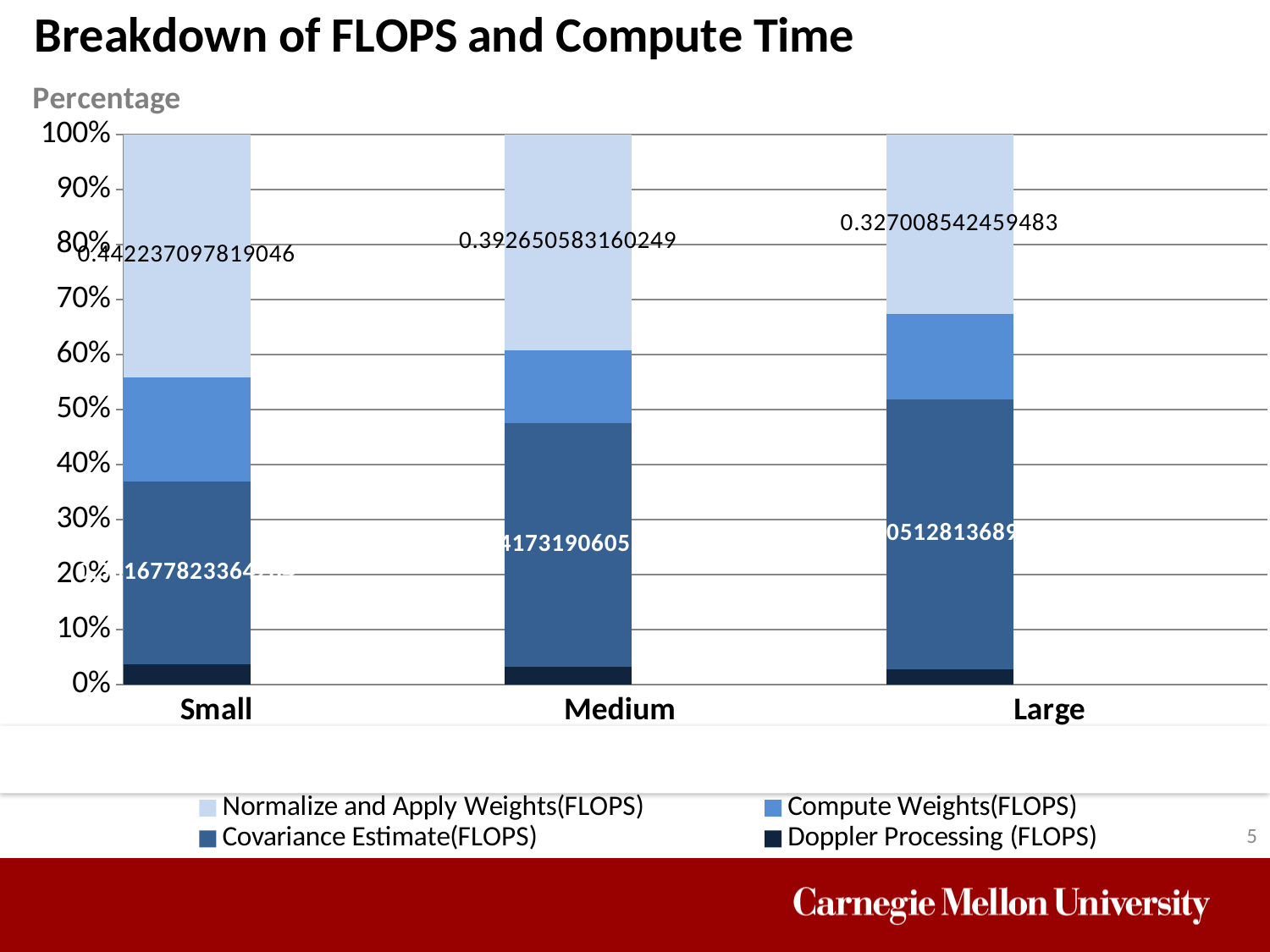
Which category has the highest labelled value for Normalize and Apply Weights(FLOPS)? Small Which category has the lowest labelled value for Normalize and Apply Weights(FLOPS)? Large What is the data label for Normalize and Apply Weights(FLOPS) on the Medium bar? 0.392650583160249 How many series does the legend list? 4 What is the data label for Normalize and Apply Weights(FLOPS) on the Large bar? 0.327008542459483 Does the Normalize and Apply Weights(FLOPS) value rise or fall going from Small to Large? fall What kind of chart is shown on the slide? stacked bar chart Is the Doppler Processing (FLOPS) segment in the Small bar greater or less than 10%? less What is the data label for Normalize and Apply Weights(FLOPS) on the Small bar? 0.442237097819046 How many categories are shown on the x axis? 3 Is the Normalize and Apply Weights(FLOPS) value larger for Small or for Medium? Small Is the top of the Covariance Estimate(FLOPS) segment in the Large bar greater or less than 40%? greater